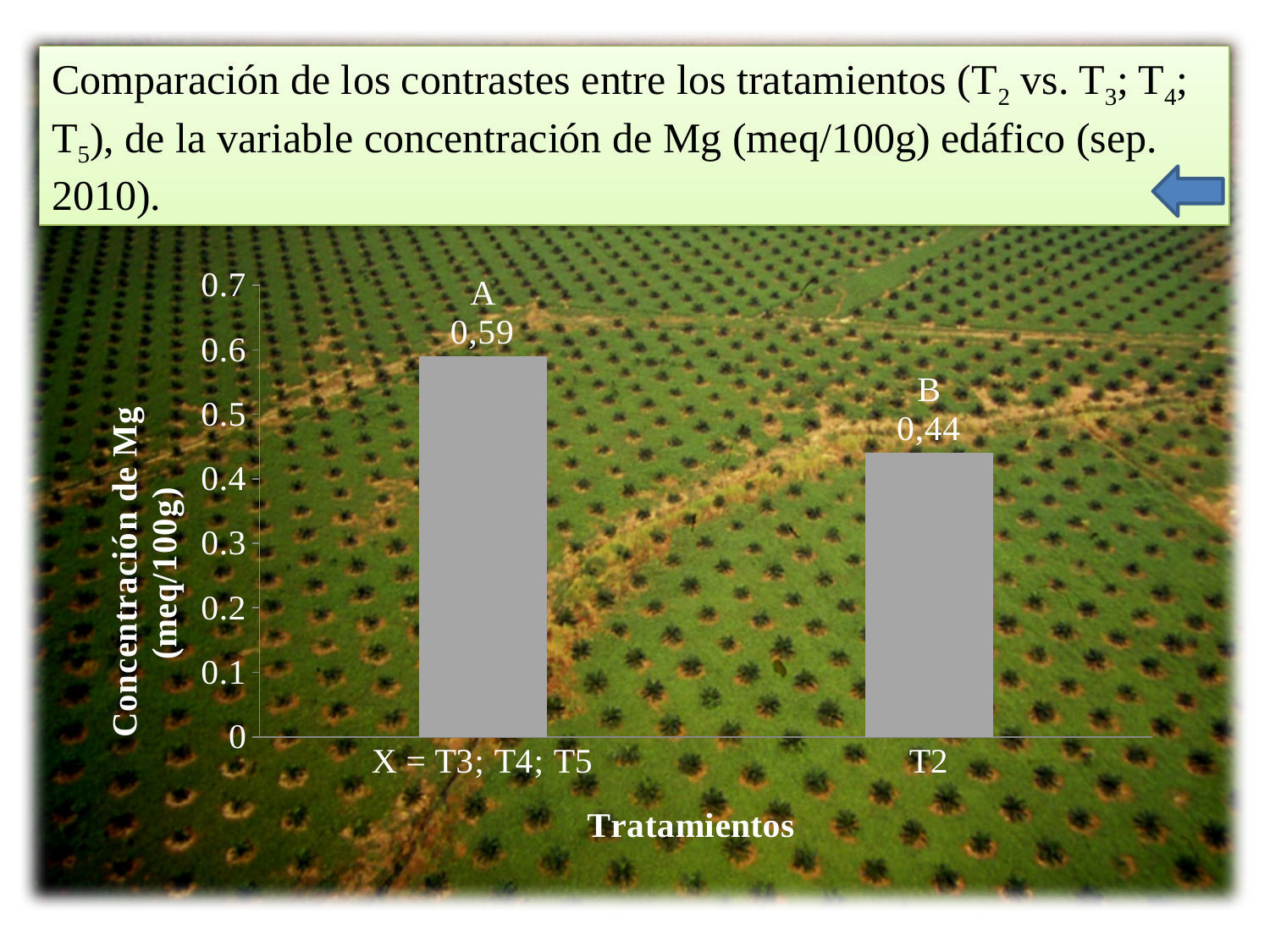
What letter is printed above the bar for T2? B What kind of chart is shown on the slide? bar chart What is the label of the x axis of the chart? Tratamientos Which is larger, the value for T2 or the value for X = T3; T4; T5? X = T3; T4; T5 Which category has the highest Mg concentration? X = T3; T4; T5 What is the Mg concentration value for the category X = T3; T4; T5? 0,59 Is the value for X = T3; T4; T5 greater or less than 0.5? greater How many categories are shown on the x axis of the chart? 2 Which category has the lowest Mg concentration? T2 What is the difference between the Mg concentration for X = T3; T4; T5 and for T2? 0,15 What is the Mg concentration value for T2? 0,44 Is the value for T2 greater or less than 0.5? less